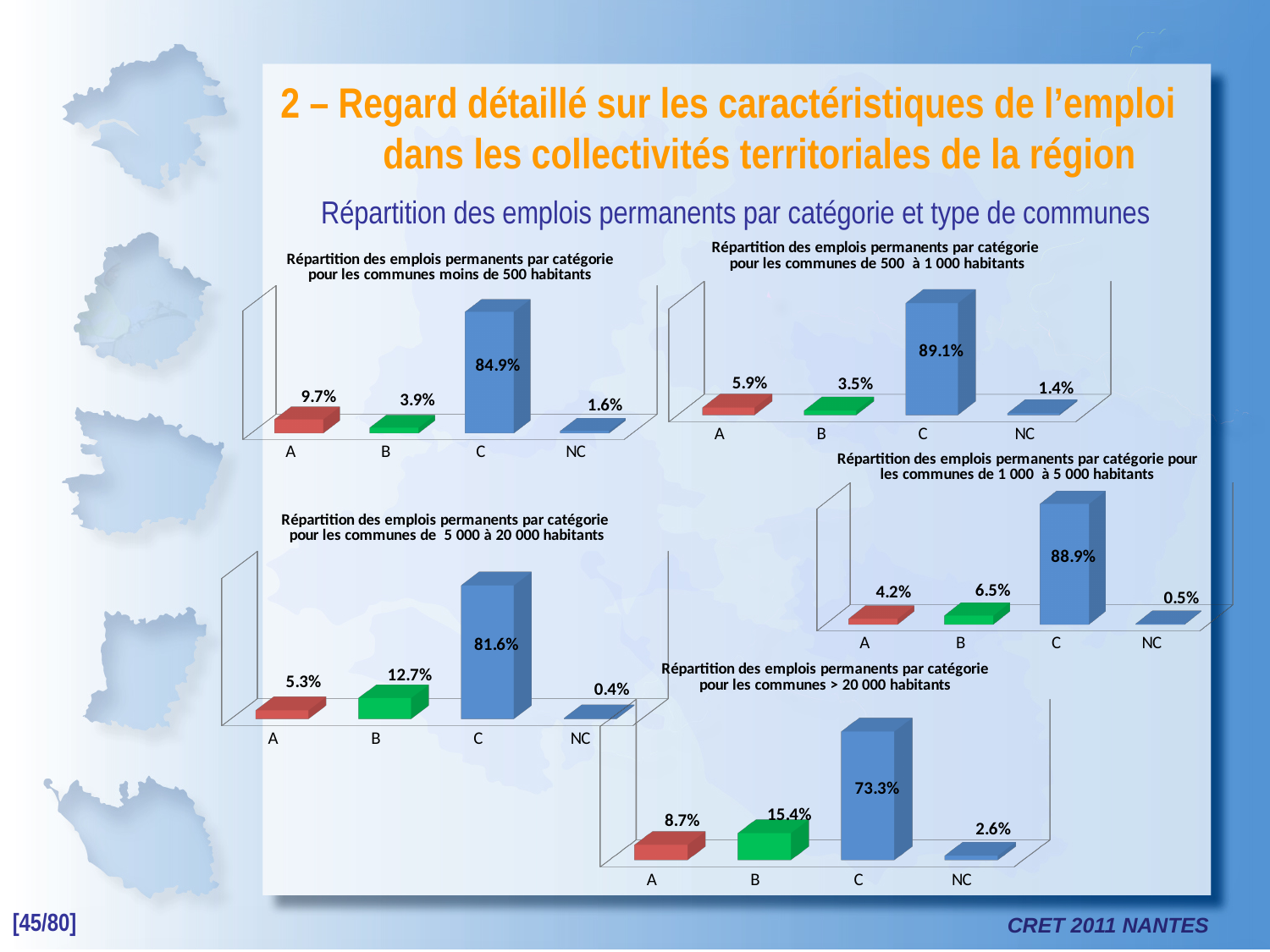
In the chart for communes de 500 à 1 000 habitants, what is the value for category A? 5.9% How many charts are shown on the slide? 5 In the chart for communes de 1 000 à 5 000 habitants, which is larger, the value for A or the value for B? B In the chart for communes moins de 500 habitants, which category has the lowest value? NC How many categories are shown in the chart for communes de 5 000 à 20 000 habitants? 4 In the chart for communes > 20 000 habitants, what is the difference between the values for B and A? 6.7% In the chart for communes de 500 à 1 000 habitants, what is the difference between the values for C and A? 83.2% In the chart for communes de 5 000 à 20 000 habitants, what is the value for category B? 12.7% What type of chart is used for communes > 20 000 habitants? Bar chart In the chart for communes moins de 500 habitants, what is the value for category C? 84.9% In the chart for communes de 1 000 à 5 000 habitants, what is the value for NC? 0.5% In the chart for communes > 20 000 habitants, which category has the highest value? C